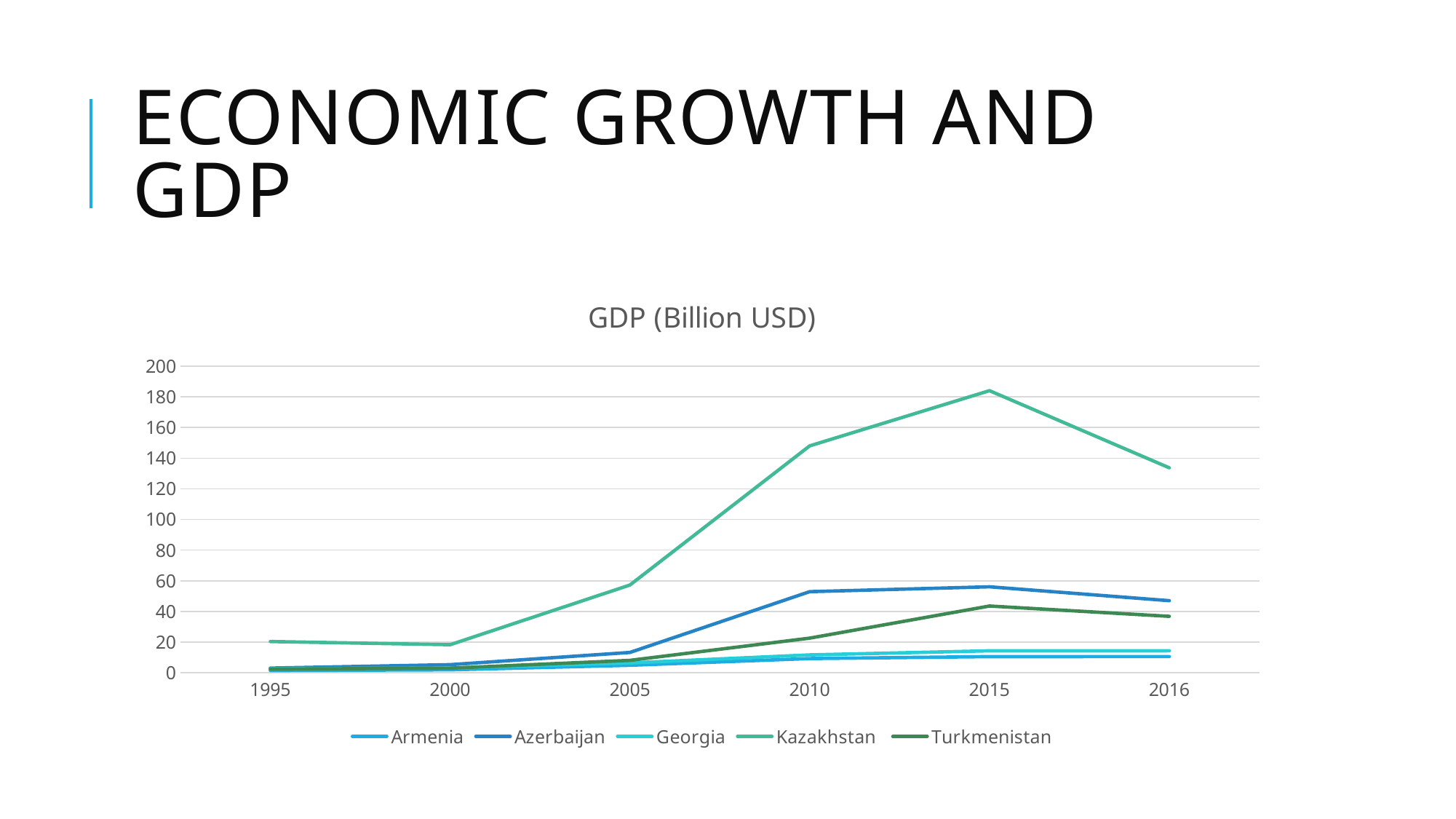
How many years are plotted along the x axis? 6 Does the value for Kazakhstan rise or fall from 2015 to 2016? fall Is the value for Kazakhstan in 2016 greater or less than 120? greater Is the value for Azerbaijan in 2015 greater or less than 40? greater What kind of chart is shown on the slide? line chart Which is larger in 2016, the value for Azerbaijan or the value for Turkmenistan? Azerbaijan Which country has the highest GDP in 2010? Kazakhstan How many series does the legend list? 5 Is the value for Azerbaijan in 2005 greater or less than 20? less What is the title of the chart? GDP (Billion USD) Which country has the highest GDP in 2015? Kazakhstan